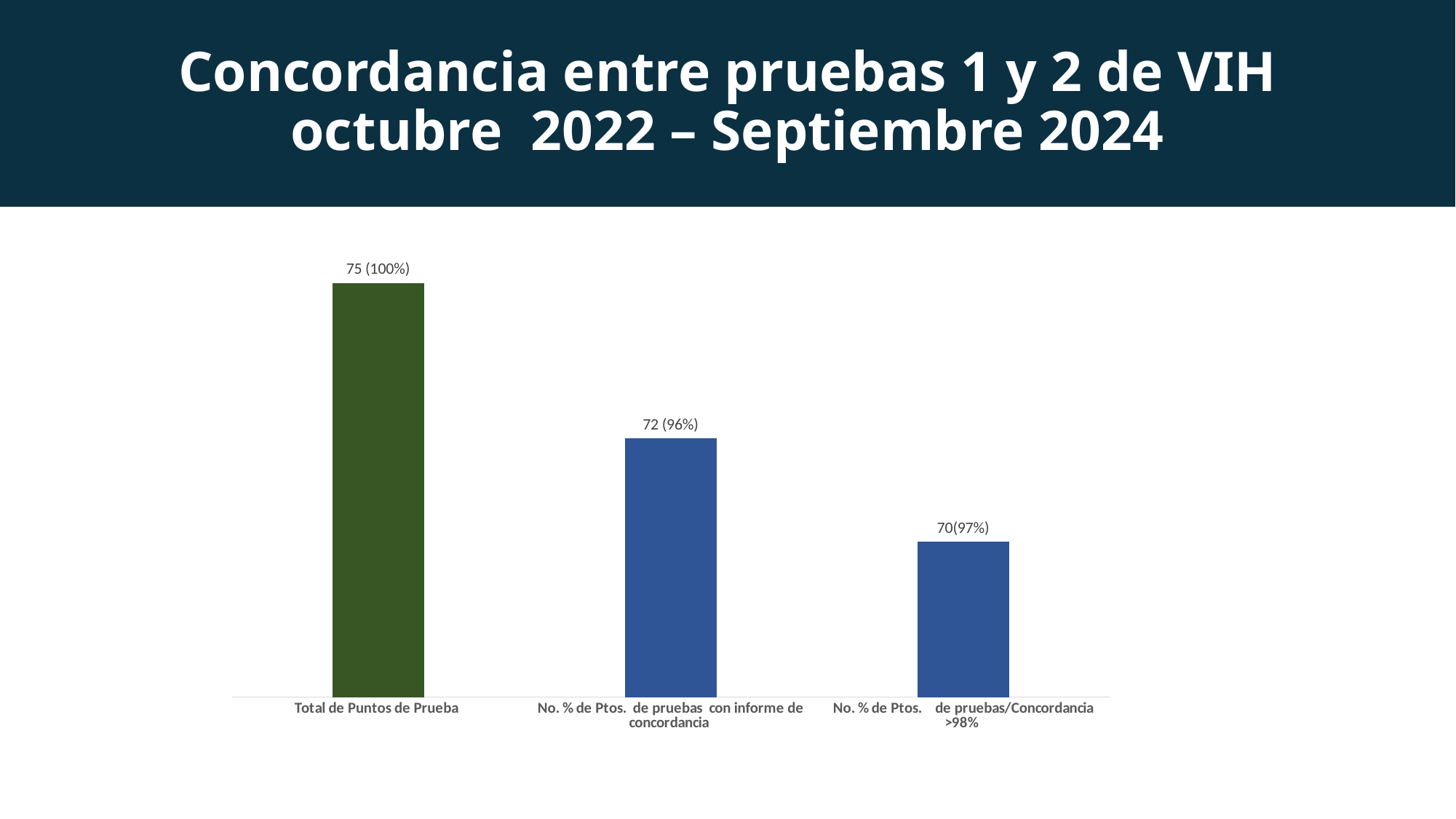
What is the data label on the bar for "Total de Puntos de Prueba"? 75 (100%) What is the difference in count between "No. % de Ptos. de pruebas con informe de concordancia" and "No. % de Ptos. de pruebas/Concordancia >98%"? 2 Which is larger: the count for "Total de Puntos de Prueba" or the count for "No. % de Ptos. de pruebas/Concordancia >98%"? Total de Puntos de Prueba What kind of chart is shown on the slide? Bar chart Which category has the lowest bar? No. % de Ptos. de pruebas/Concordancia >98% What is the data label on the bar for "No. % de Ptos. de pruebas con informe de concordancia"? 72 (96%) Do the bar values rise or fall from left to right along the x axis? Fall What is the difference in count between "Total de Puntos de Prueba" and "No. % de Ptos. de pruebas con informe de concordancia"? 3 What colour is the bar for "Total de Puntos de Prueba"? Green How many categories are shown on the x axis? 3 What is the data label on the bar for "No. % de Ptos. de pruebas/Concordancia >98%"? 70(97%) Which category has the highest bar? Total de Puntos de Prueba